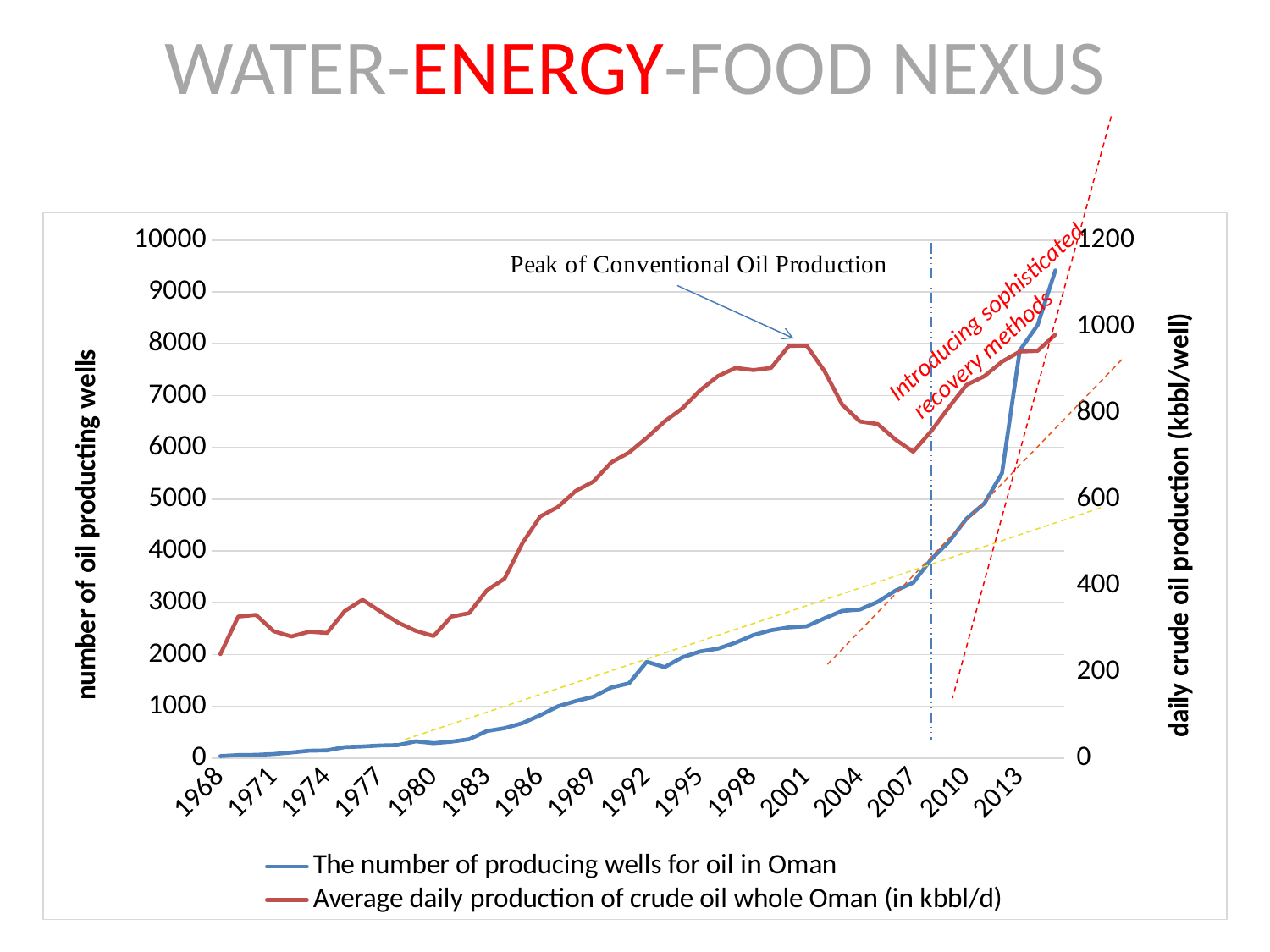
What is the label of the right vertical axis? daily crude oil production (kbbl/well) Does the average daily production of crude oil in Oman rise or fall between 2001 and 2007? fall Around which year does the average daily production of crude oil in Oman reach its highest value? 2015 Is the average daily production of crude oil in Oman in 2001 greater or less than 800 kbbl/d? greater Is the number of producing wells for oil in Oman in 1992 greater or less than 2000? less What is the label of the left vertical axis? number of oil producing wells Is the number of producing wells for oil in Oman in 2013 greater or less than 5000? greater How many series does the chart legend list? 2 Does the number of producing wells for oil in Oman rise or fall from 1968 to 2013? rise What kind of chart is shown on the slide? line chart